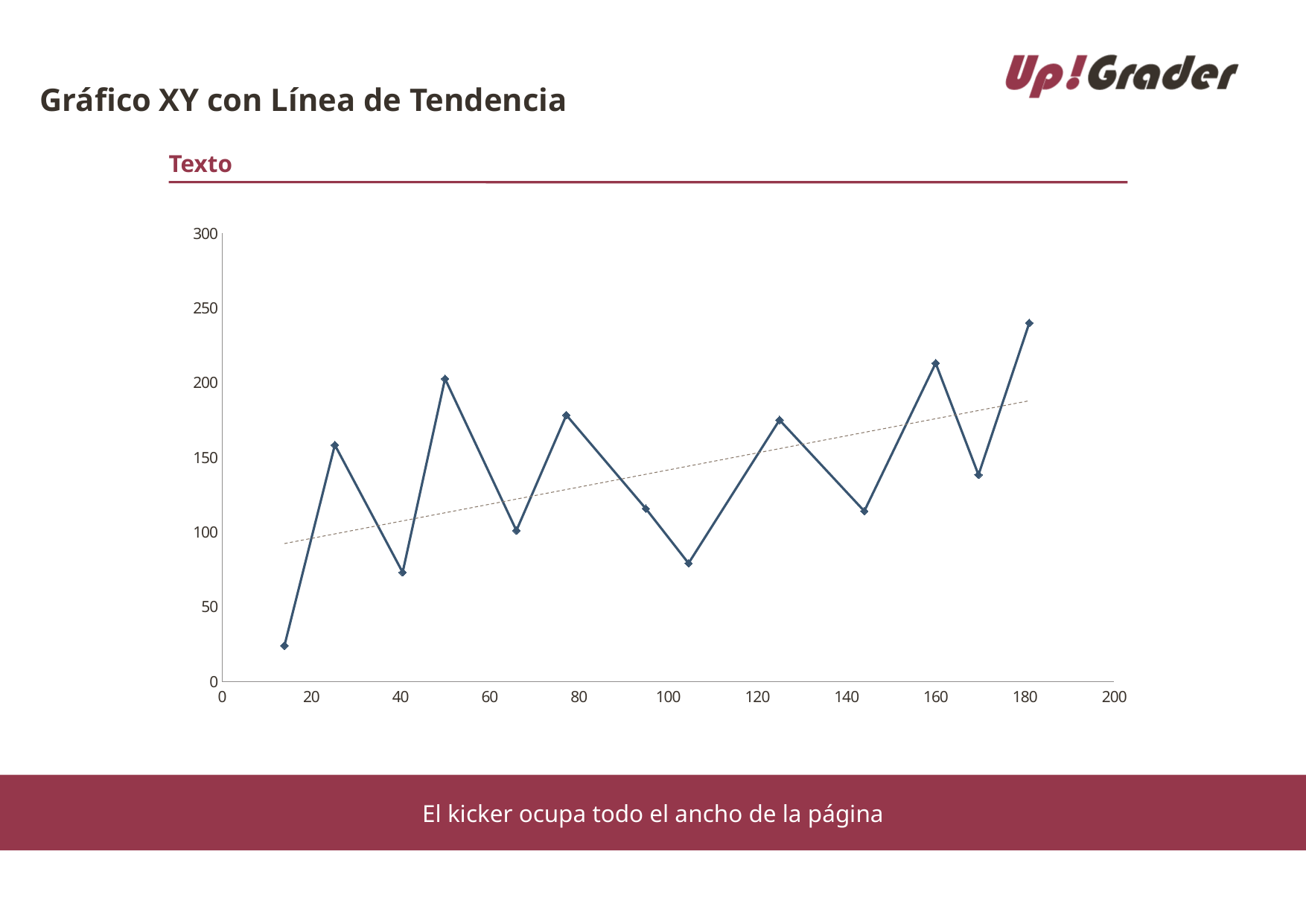
How many data points are plotted on the chart? 13 Is the lowest data point the leftmost or the rightmost point on the chart? leftmost Is the value of the data point near x=125 greater or less than 150? greater Does the dashed trendline rise or fall as x increases? rises What is the maximum value shown on the y axis? 300 What is the title of the slide's chart? Gráfico XY con Línea de Tendencia Is the value of the first (leftmost) data point greater or less than 50? less Is the value of the last (rightmost) data point greater or less than 200? greater Is the highest data point the leftmost or the rightmost point on the chart? rightmost Which has the larger value: the data point near x=144 or the data point near x=160? the point near x=160 What type of chart is shown on the slide? XY scatter chart with lines (line chart with a trendline)